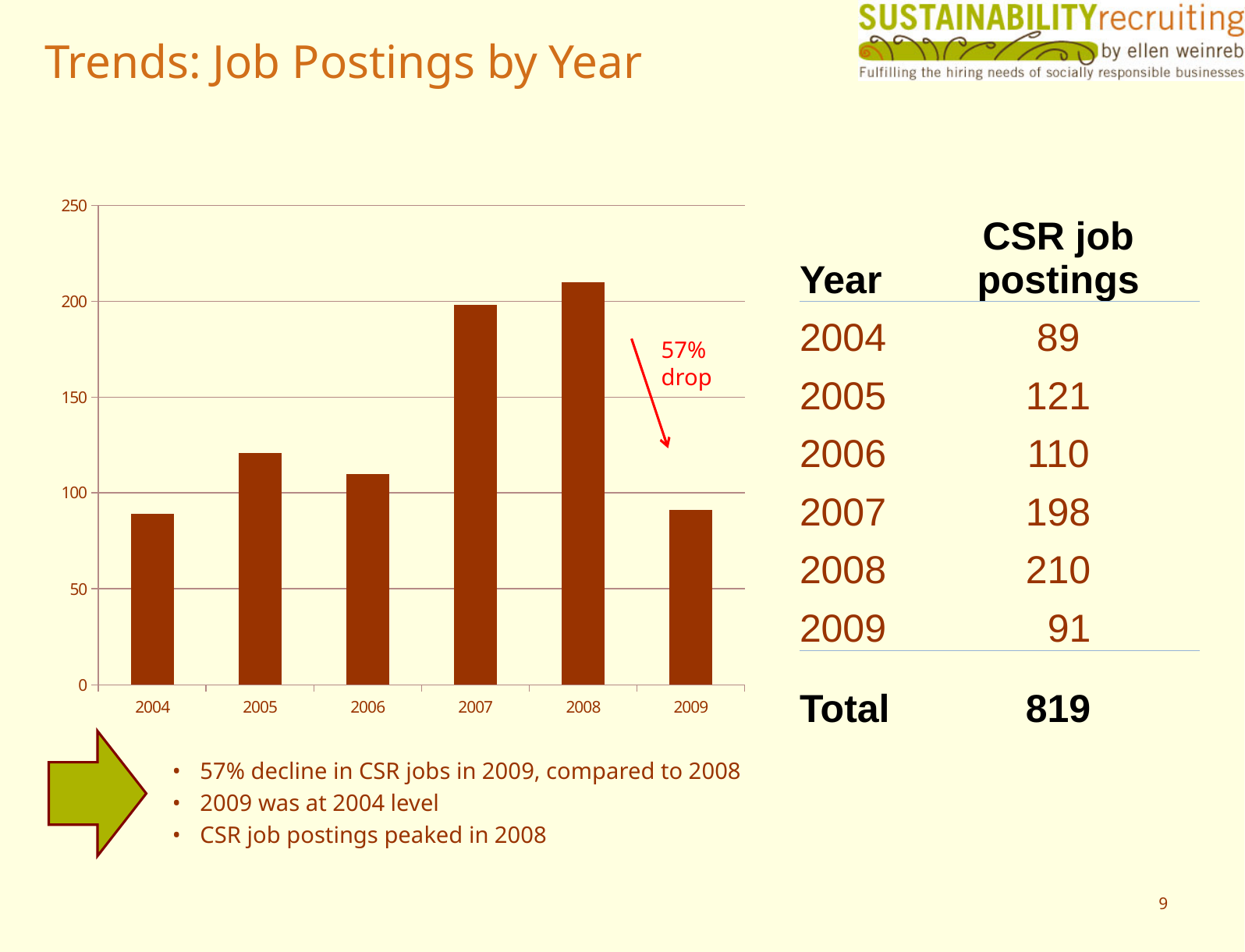
What is the difference in CSR job postings between 2008 and 2009? 119 What kind of chart is shown on the slide? bar chart Do CSR job postings rise or fall from 2008 to 2009? fall How many CSR job postings were there in 2009? 91 How many years are plotted on the x axis of the chart? 6 Is the value for 2008 greater or less than 200? greater How many CSR job postings were there in 2007? 198 Which year has the lowest number of CSR job postings? 2004 Which year has the highest number of CSR job postings? 2008 Is the value for 2006 greater or less than 150? less What percentage drop is annotated on the chart between 2008 and 2009? 57% Which year had more CSR job postings, 2005 or 2006? 2005